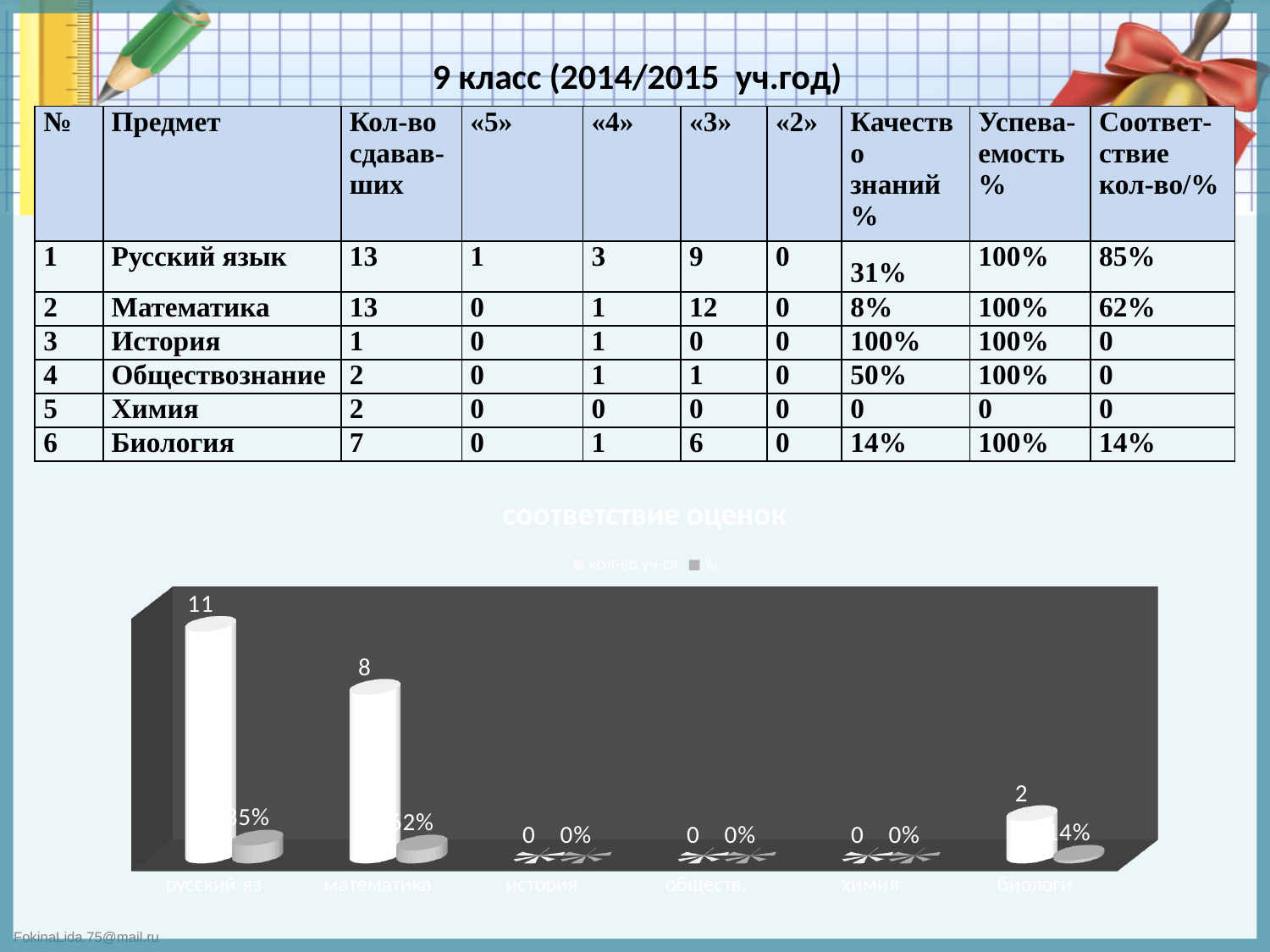
How many categories are shown on the x axis of the chart? 6 What is the difference between the 'кол-во уч-ся' values for 'русский яз' and 'математика'? 3 Which category has the highest value in the 'кол-во уч-ся' series? русский яз Which has a larger 'кол-во уч-ся' value: 'математика' or 'биологи'? математика What is the value of the 'кол-во уч-ся' series for 'математика' in the chart? 8 What is the value of the 'кол-во уч-ся' series for 'биологи' in the chart? 2 What is the title of the chart on the slide? соответствие оценок What is the value of the 'кол-во уч-ся' series for 'русский яз' in the chart? 11 How many series does the chart legend list? 2 What are the two legend entries of the chart? кол-во уч-ся and % What is the value of the '%' series for 'история' in the chart? 0% What kind of chart is shown on the slide? bar chart